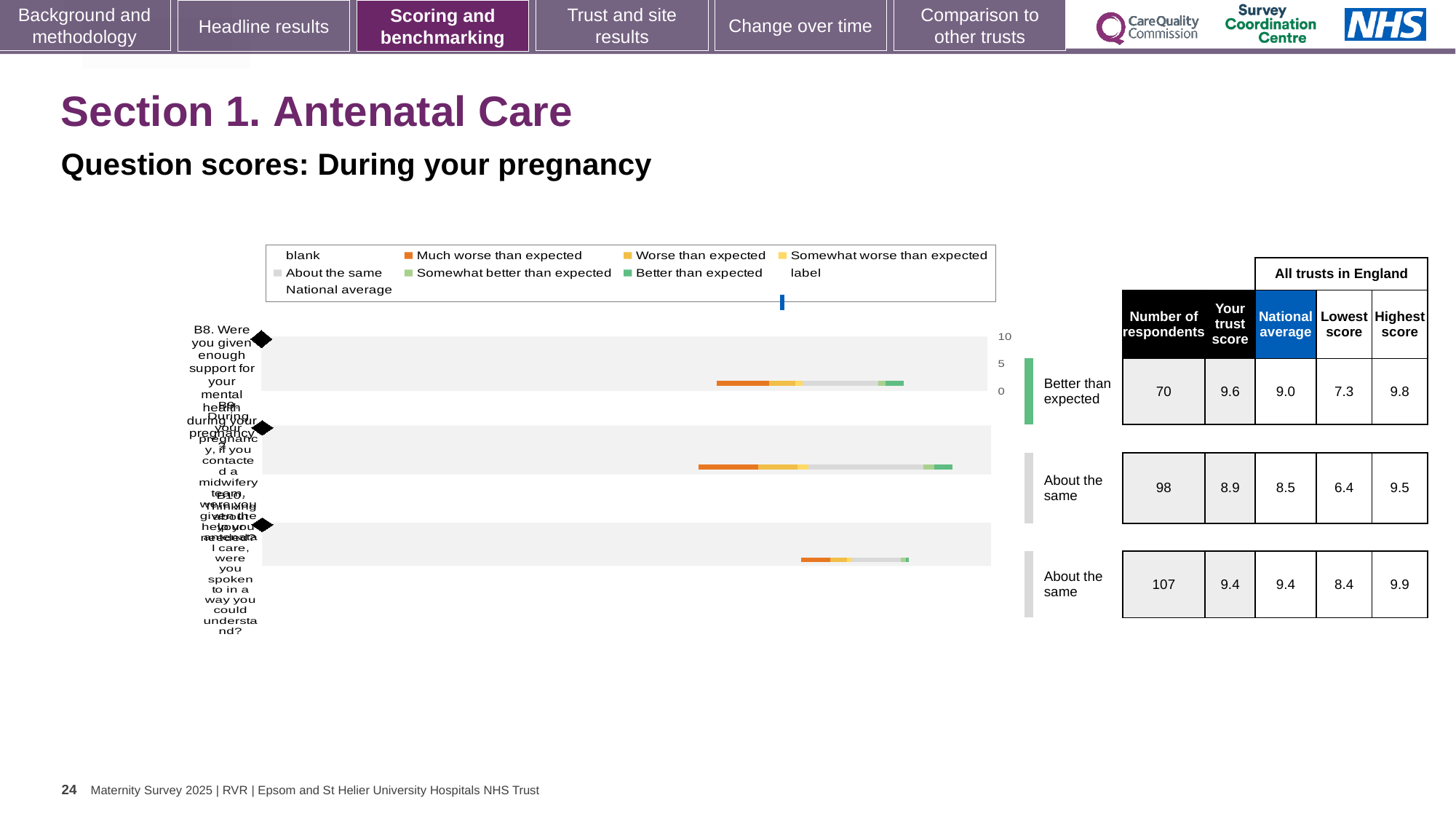
For the second row, which is larger: the trust score or the national average? Your trust score (8.9) Which row has the lowest 'Your trust score'? The second row (8.9) What colour does the legend use for 'Much worse than expected'? Orange What is the 'Your trust score' for question B8 (support for your mental health during pregnancy)? 9.6 How many respondents are listed for question B8, the first row of the chart? 70 What is the national average for the first row (B8) in the table beside the chart? 9.0 How many survey questions (rows) are plotted in the chart? 3 Which row has the highest number of respondents? The third row (107) What is the difference between the highest score and the lowest score for the first row (B8)? 2.5 What benchmark category is shown for the first row (B8)? Better than expected What is the lowest score in England for the third row? 8.4 What kind of chart is shown on the slide? Bar chart